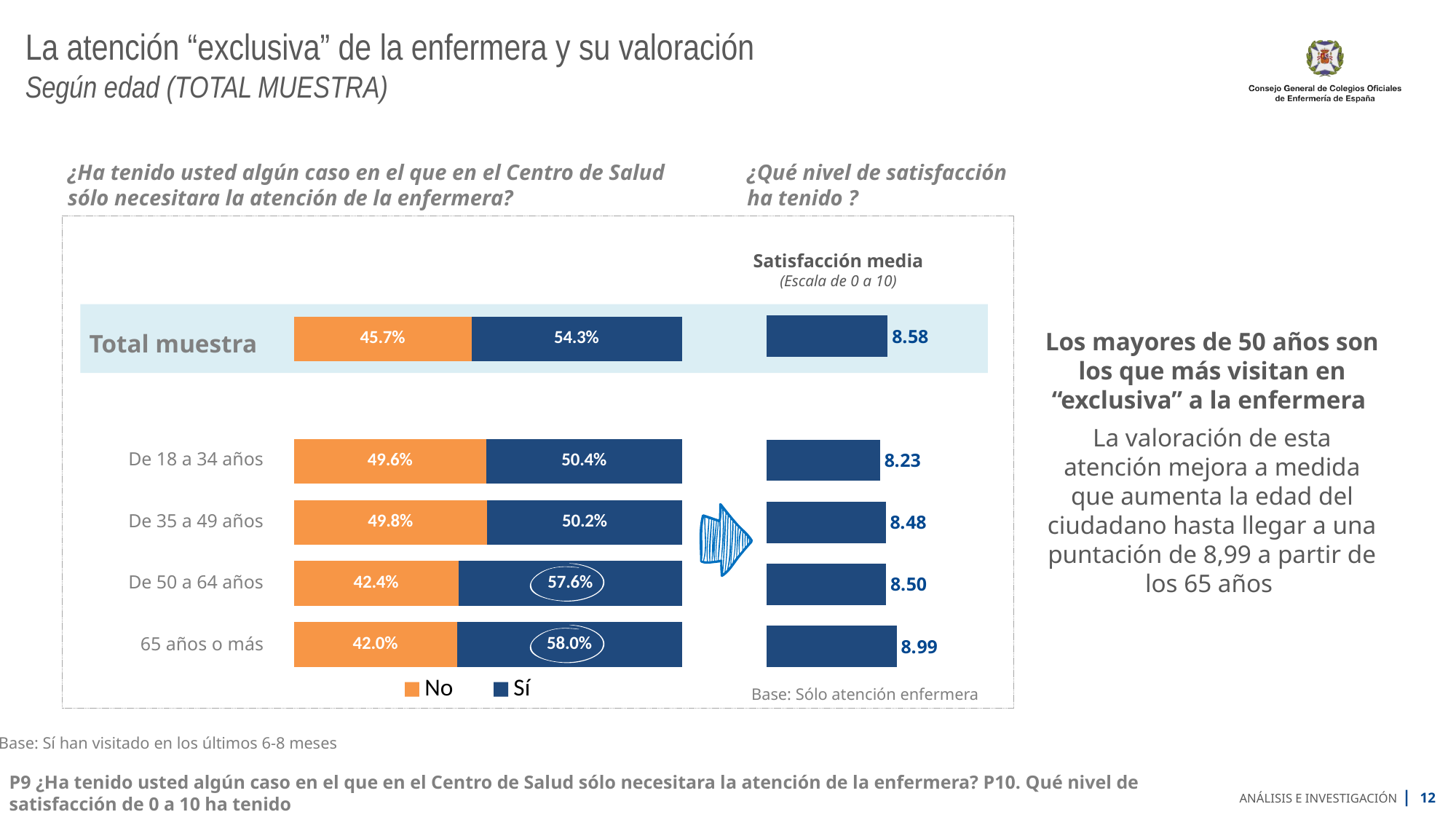
In the "Satisfacción media" chart, what is the value for "De 35 a 49 años"? 8.48 In the stacked bar chart on the left, what percentage answered "Sí" in the "65 años o más" group? 58.0% In the stacked bar chart on the left, what percentage answered "No" in the "De 18 a 34 años" group? 49.6% In the stacked bar chart on the left, what is the total of the "Total muestra" bar? 100.0% In the stacked bar chart on the left, what colour represents the "No" series? Orange In the "Satisfacción media" chart, which age group has the highest value? 65 años o más In the "Satisfacción media" chart, which age group has the lowest value? De 18 a 34 años In the "Satisfacción media" chart, what is the difference between the values for "65 años o más" and "De 18 a 34 años"? 0.76 What kind of chart is the "Satisfacción media" chart? Bar chart How many series does the legend of the stacked bar chart on the left list? 2 In the stacked bar chart on the left, which group has a larger "Sí" percentage: "De 50 a 64 años" or "De 18 a 34 años"? De 50 a 64 años In the stacked bar chart on the left, what is the difference between the "Sí" and "No" percentages for "Total muestra"? 8.6 percentage points